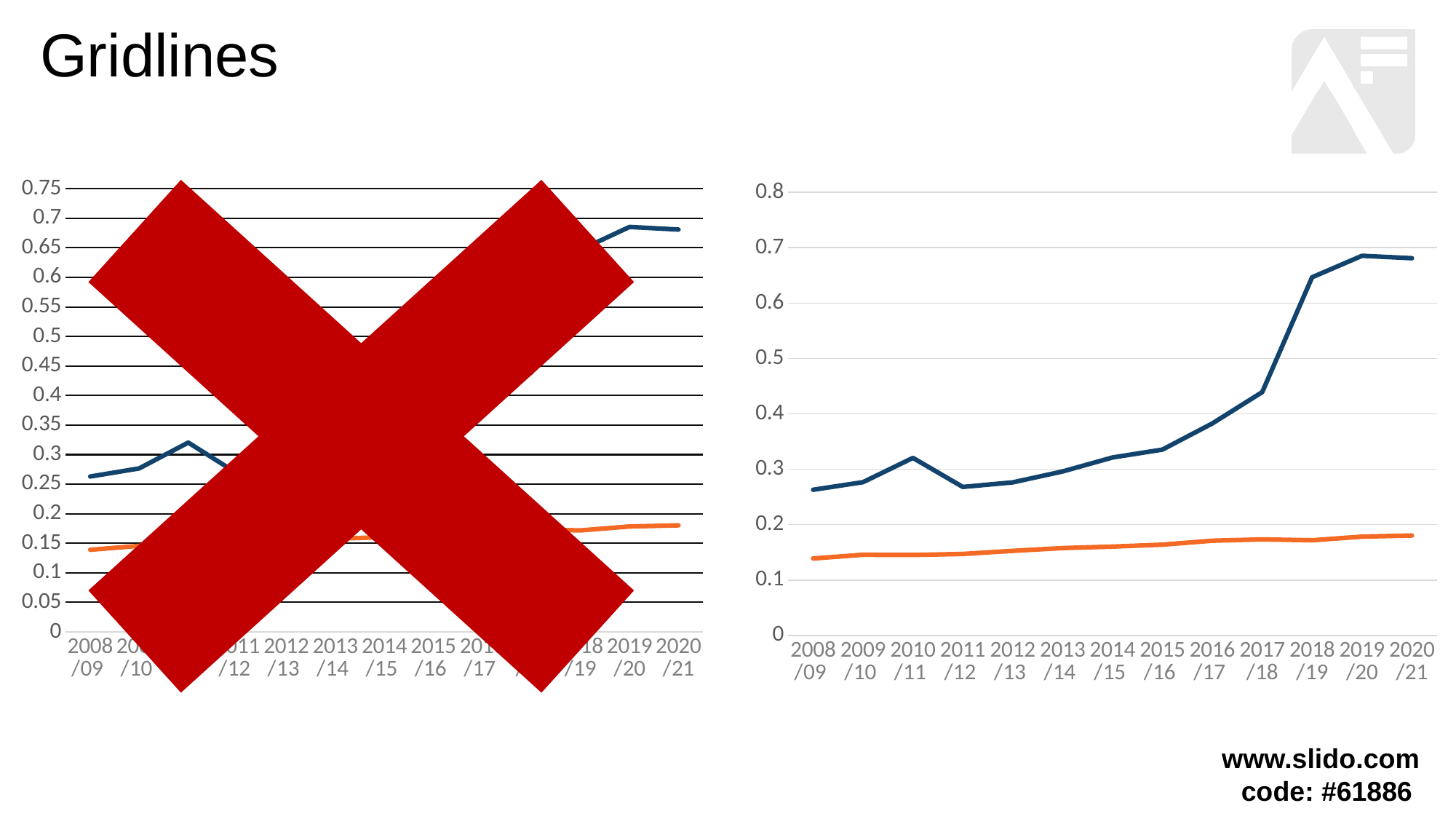
On the right chart, does the orange line generally rise or fall from 2008/09 to 2020/21? rise What is the highest value labelled on the y axis of the right chart? 0.8 On the right chart, is the value of the dark blue line for 2019/20 greater or less than 0.6? greater On the right chart, which is larger for 2017/18: the dark blue line or the orange line? the dark blue line On the right chart, is the value of the orange line for 2020/21 greater or less than 0.2? less On the right chart, is the value of the dark blue line for 2008/09 greater or less than 0.3? less What kind of chart is the chart on the right side of the slide? line chart What is drawn over the chart on the left side of the slide? a large red X On the right chart, how many year categories are shown along the x axis? 13 On the right chart, which is larger for the dark blue line: the value for 2010/11 or the value for 2011/12? 2010/11